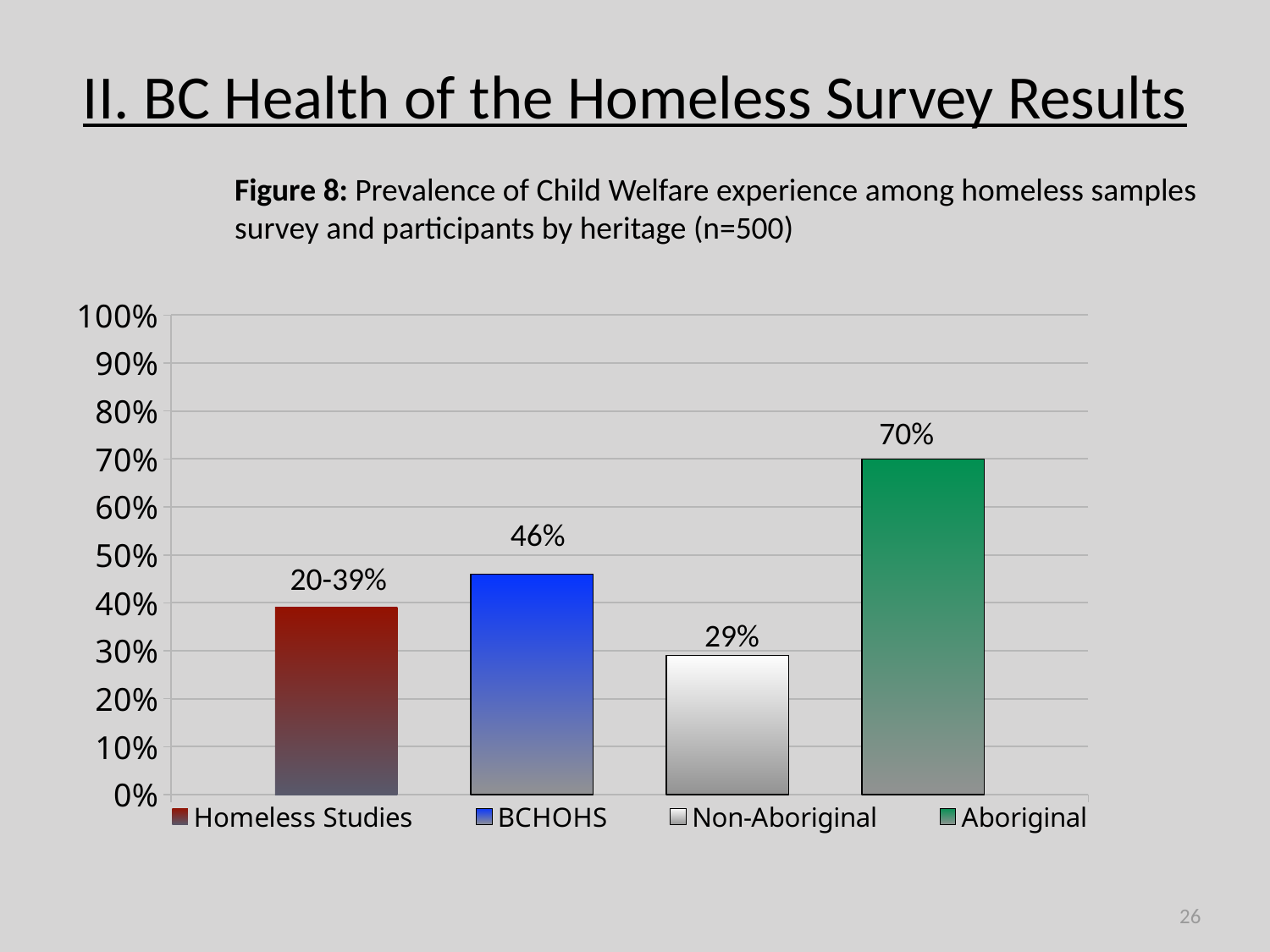
What label is printed above the Homeless Studies bar? 20-39% Which category has the highest value? Aboriginal Is the value for Homeless Studies greater or less than 30%? greater Which is larger, the value for BCHOHS or the value for Non-Aboriginal? BCHOHS What value is shown for Aboriginal? 70% What is the difference between the Aboriginal and BCHOHS values? 24 percentage points What kind of chart is shown on the slide? Bar chart Which category has the lowest value? Non-Aboriginal What value is shown for Non-Aboriginal? 29% What value is shown for BCHOHS? 46% How many bars are plotted in the chart? 4 What is the difference between the BCHOHS and Non-Aboriginal values? 17 percentage points